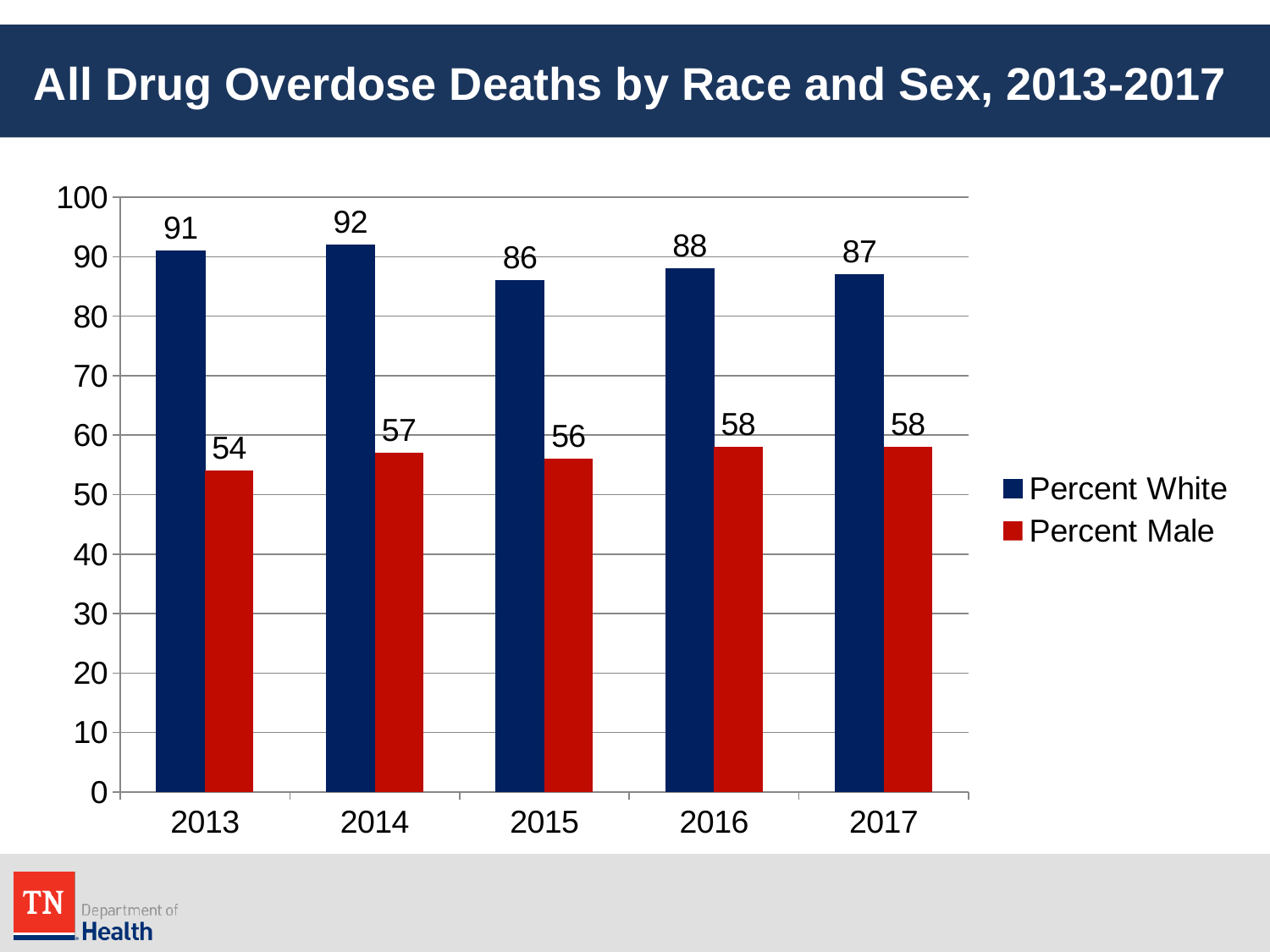
In which year is the Percent Male value lowest? 2013 How many years are shown on the x axis? 5 Which is larger, the Percent White value for 2013 or for 2015? 2013 In which year is the Percent White value highest? 2014 How many series does the legend list? 2 What is the difference between Percent White and Percent Male in 2017? 29 In which year is the Percent White value lowest? 2015 What is the Percent Male value for 2016? 58 What is the difference between the Percent Male values for 2014 and 2013? 3 What is the Percent White value for 2014? 92 What kind of chart is shown on the slide? Bar chart What is the Percent Male value for 2013? 54